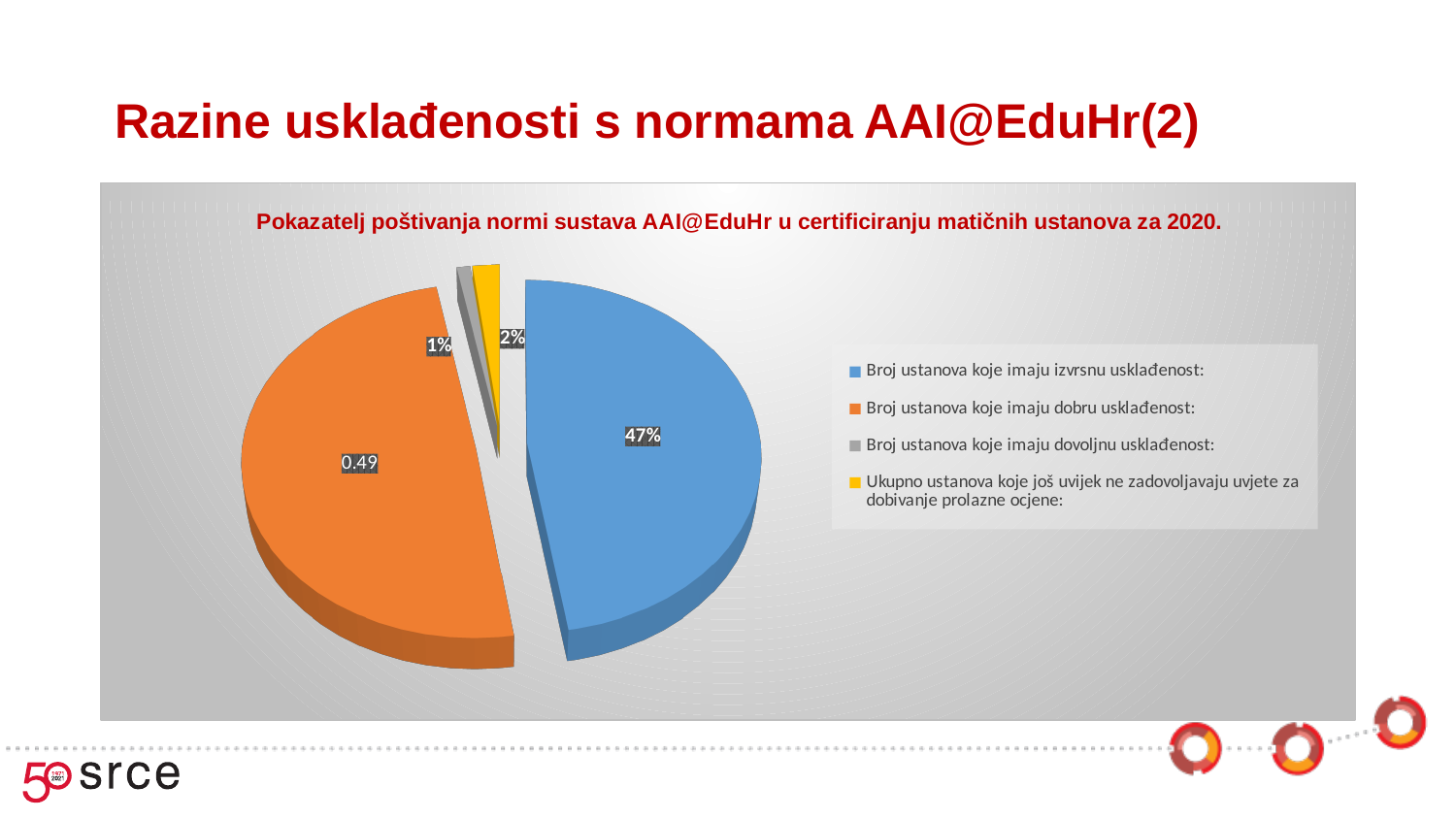
What value is shown for 'Broj ustanova koje imaju izvrsnu usklađenost:'? 47% What is the title of the chart? Pokazatelj poštivanja normi sustava AAI@EduHr u certificiranju matičnih ustanova za 2020. How many slices does the pie chart have? 4 What type of chart is shown on the slide? pie chart What is the difference between the slice for 'Ukupno ustanova koje još uvijek ne zadovoljavaju uvjete za dobivanje prolazne ocjene:' and the slice for 'Broj ustanova koje imaju dovoljnu usklađenost:'? 1% Which is larger: the slice for 'Broj ustanova koje imaju dovoljnu usklađenost:' or the slice for 'Ukupno ustanova koje još uvijek ne zadovoljavaju uvjete za dobivanje prolazne ocjene:'? Ukupno ustanova koje još uvijek ne zadovoljavaju uvjete za dobivanje prolazne ocjene: What value is shown for 'Broj ustanova koje imaju dovoljnu usklađenost:'? 1% Which category has the smallest slice of the pie? Broj ustanova koje imaju dovoljnu usklađenost: Which is larger: the slice for 'Broj ustanova koje imaju izvrsnu usklađenost:' or the slice for 'Broj ustanova koje imaju dovoljnu usklađenost:'? Broj ustanova koje imaju izvrsnu usklađenost: What value is shown for 'Ukupno ustanova koje još uvijek ne zadovoljavaju uvjete za dobivanje prolazne ocjene:'? 2% What value is shown for 'Broj ustanova koje imaju dobru usklađenost:'? 0.49 Which colour represents 'Broj ustanova koje imaju izvrsnu usklađenost:' in the legend? blue